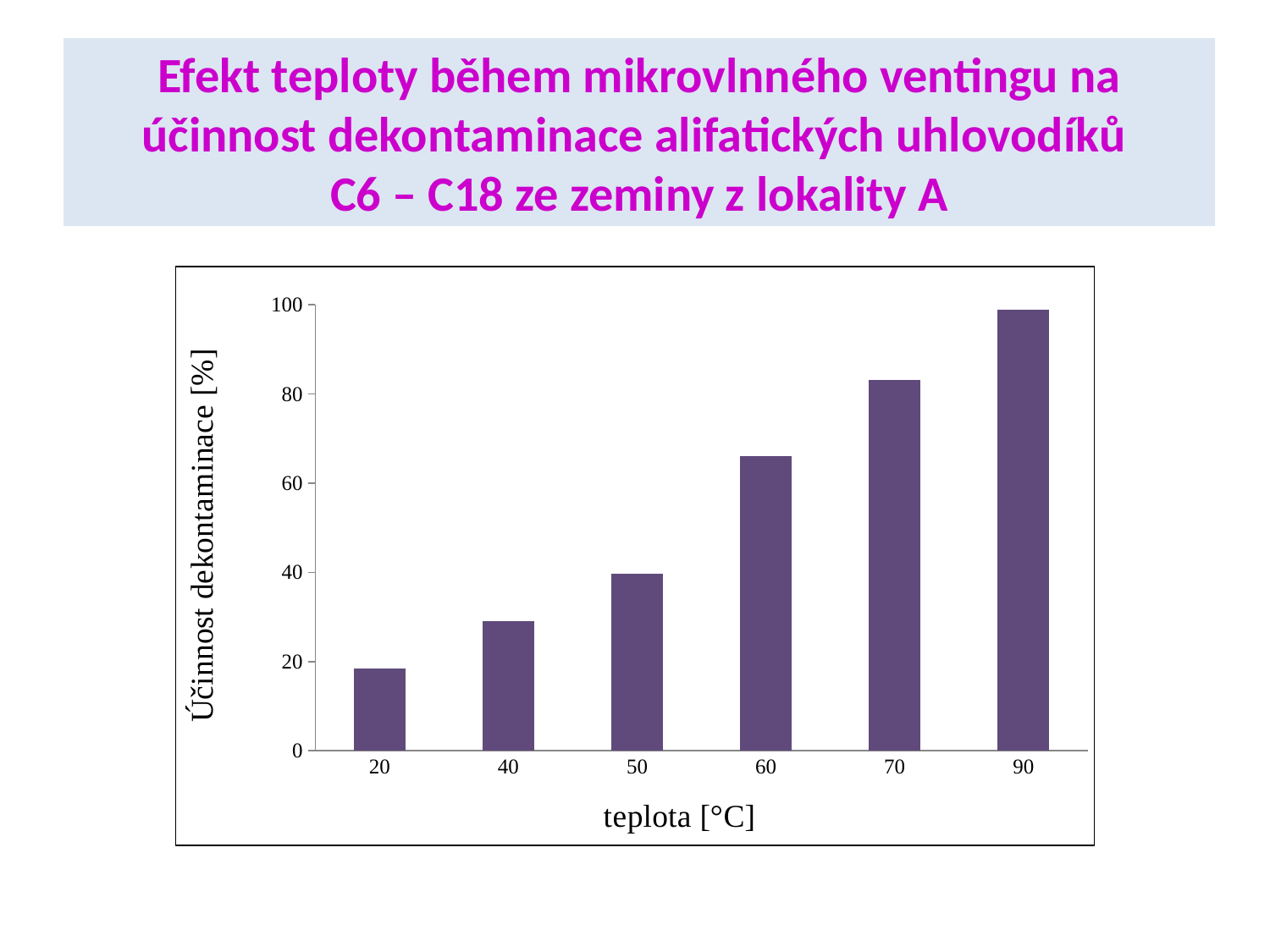
Which temperature has the highest decontamination efficiency? 90 Is the decontamination efficiency at 60 °C greater or less than 60? greater Is the decontamination efficiency at 70 °C greater or less than 60? greater Which has a higher decontamination efficiency, 50 °C or 70 °C? 70 °C How many temperature categories are plotted on the x axis? 6 Which temperature has the lowest decontamination efficiency? 20 Is the decontamination efficiency at 20 °C greater or less than 40? less Do the values rise or fall as temperature increases along the x axis? rise What kind of chart is shown on the slide? bar chart What is the label of the x axis? teplota [°C]